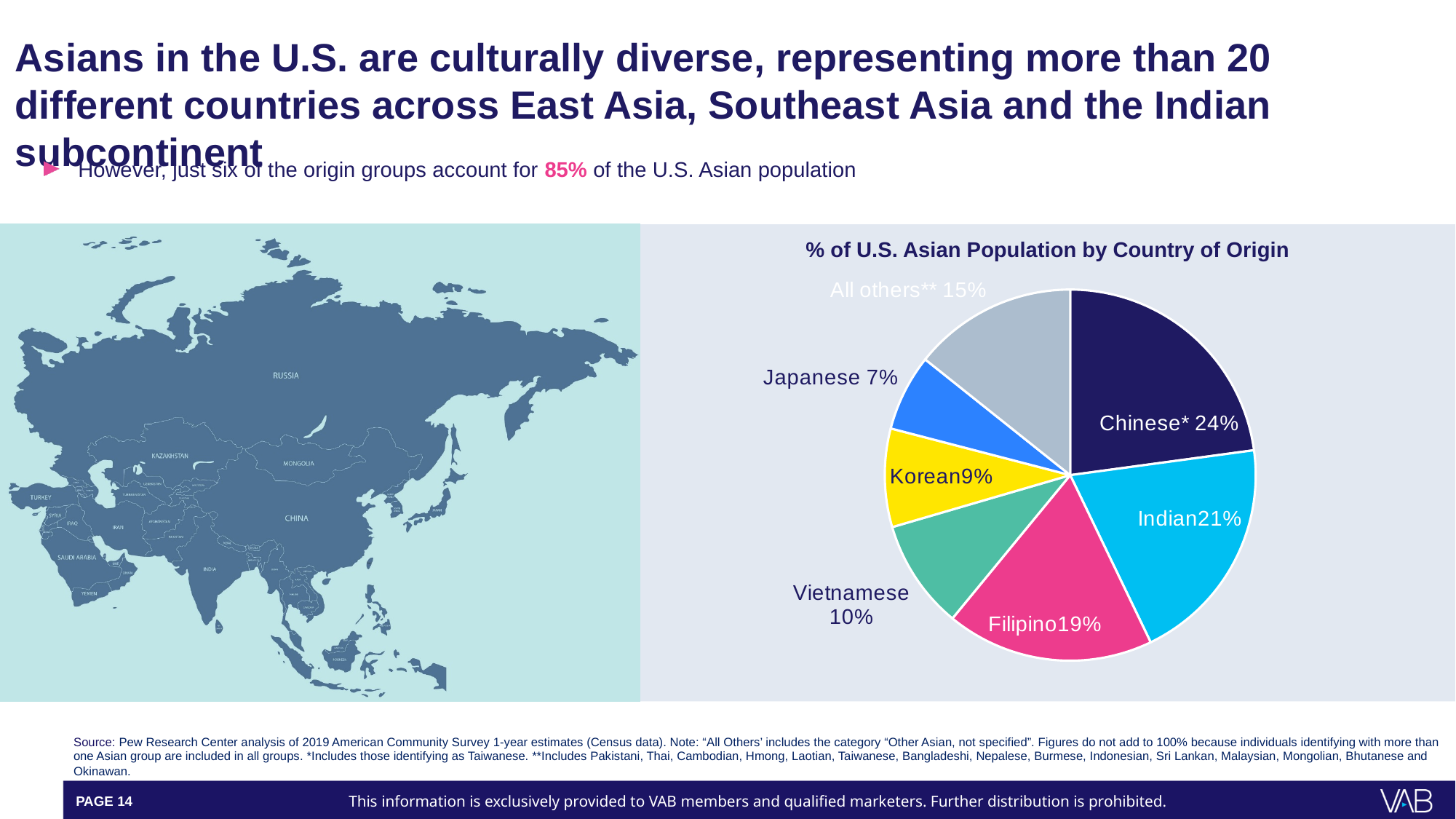
What percentage of the U.S. Asian population is Chinese* according to the pie chart? 24% What is the title of the chart on the slide? % of U.S. Asian Population by Country of Origin What is the value shown for Vietnamese in the pie chart? 10% Which country of origin has the largest slice in the pie chart? Chinese* What percentage does the Filipino slice show? 19% What share of the pie chart is labelled Indian? 21% What is the difference in percentage points between the Chinese* and Indian slices? 3 Which named origin group (excluding All others**) has the smallest slice? Japanese Which slice is larger, Korean or Vietnamese? Vietnamese What type of chart is shown on the right side of the slide? Pie chart What percentage is shown for Japanese? 7% How many slices does the pie chart have? 7